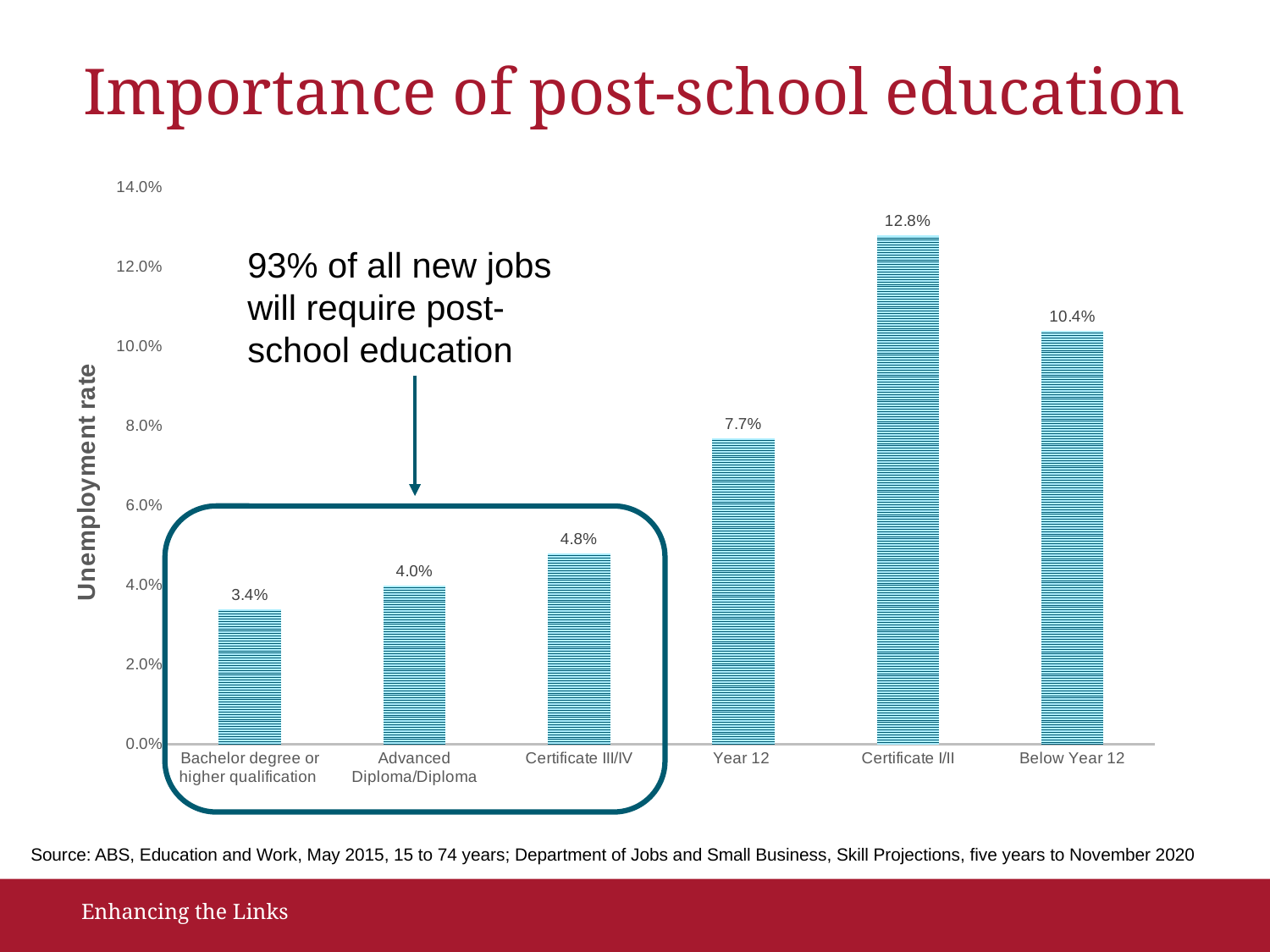
What is the unemployment rate for Certificate I/II? 12.8% What is the unemployment rate for Year 12? 7.7% Which category has the lowest unemployment rate? Bachelor degree or higher qualification What is the label of the vertical axis? Unemployment rate Is the unemployment rate for Below Year 12 greater or less than 10.0%? greater What is the difference in unemployment rate between Certificate I/II and Bachelor degree or higher qualification? 9.4% What is the unemployment rate for Bachelor degree or higher qualification? 3.4% Which category has the highest unemployment rate? Certificate I/II What type of chart is shown on the slide? Bar chart What is the difference in unemployment rate between Below Year 12 and Certificate III/IV? 5.6% How many education categories are shown on the chart? 6 Which has a higher unemployment rate, Advanced Diploma/Diploma or Year 12? Year 12